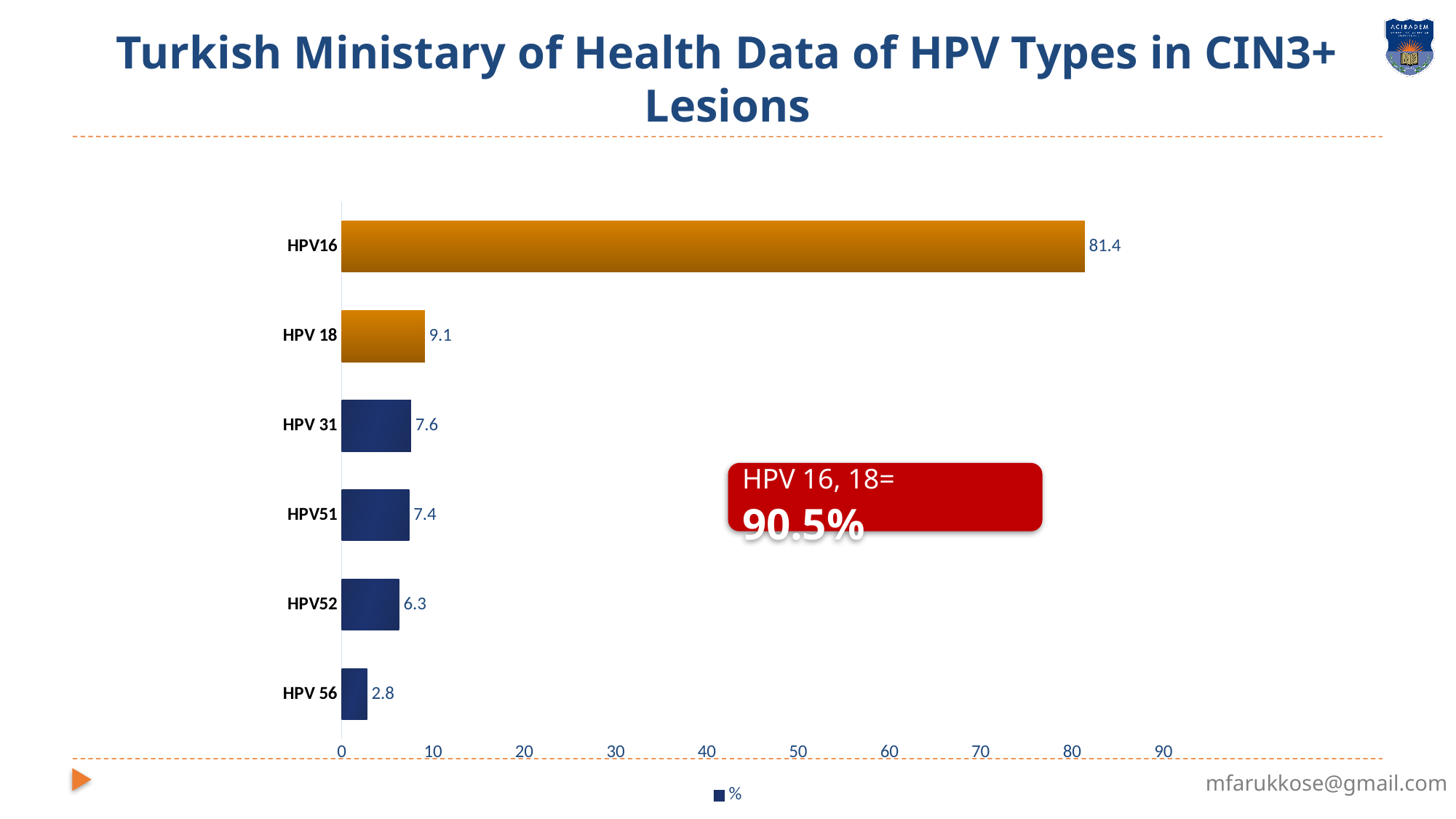
Which HPV type has the highest value? HPV16 What is the difference between the values for HPV16 and HPV 18? 72.3 What is the value for HPV 18? 9.1 Is the value for HPV16 greater or less than 80? greater How many HPV types are shown in the chart? 6 Which HPV type has the lowest value? HPV 56 What series name does the legend show? % What is the value for HPV16? 81.4 What is the value for HPV52? 6.3 Which has a larger value, HPV 18 or HPV 31? HPV 18 What kind of chart is shown on the slide? bar chart What is the difference between the values for HPV 31 and HPV 56? 4.8